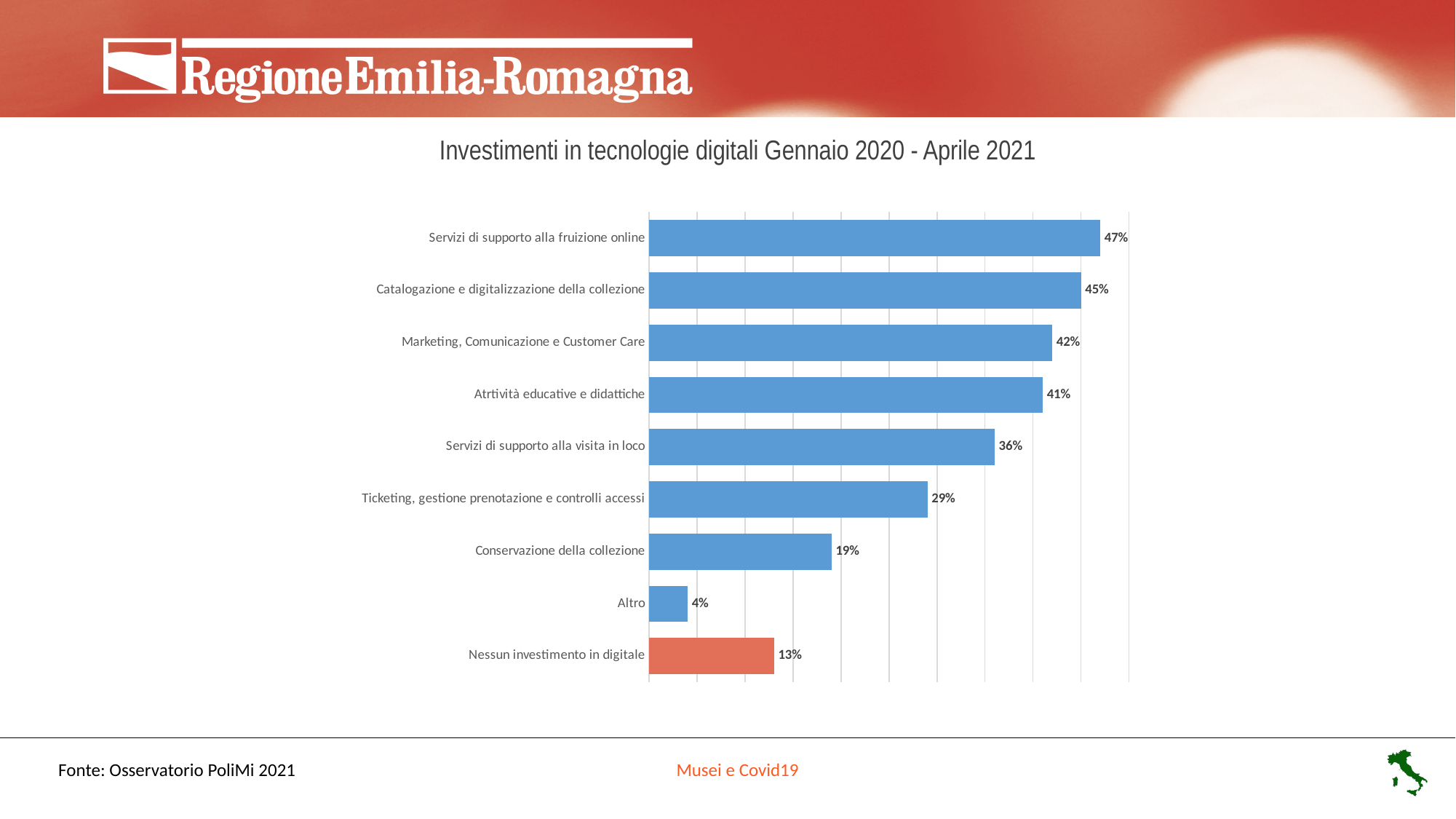
What is the difference between Catalogazione e digitalizzazione della collezione and Altro? 41% What is the value for Conservazione della collezione? 19% What is the value for Servizi di supporto alla fruizione online? 47% What is the value for Nessun investimento in digitale? 13% Which is larger: Marketing, Comunicazione e Customer Care or Atrtività educative e didattiche? Marketing, Comunicazione e Customer Care What is the title of the chart? Investimenti in tecnologie digitali Gennaio 2020 - Aprile 2021 What kind of chart is shown on the slide? Bar chart How many categories are shown in the chart? 9 Which category has the lowest value? Altro Which category has the highest value? Servizi di supporto alla fruizione online Which category's bar is coloured differently (red/orange) from the others? Nessun investimento in digitale What is the difference between Servizi di supporto alla visita in loco and Ticketing, gestione prenotazione e controlli accessi? 7%